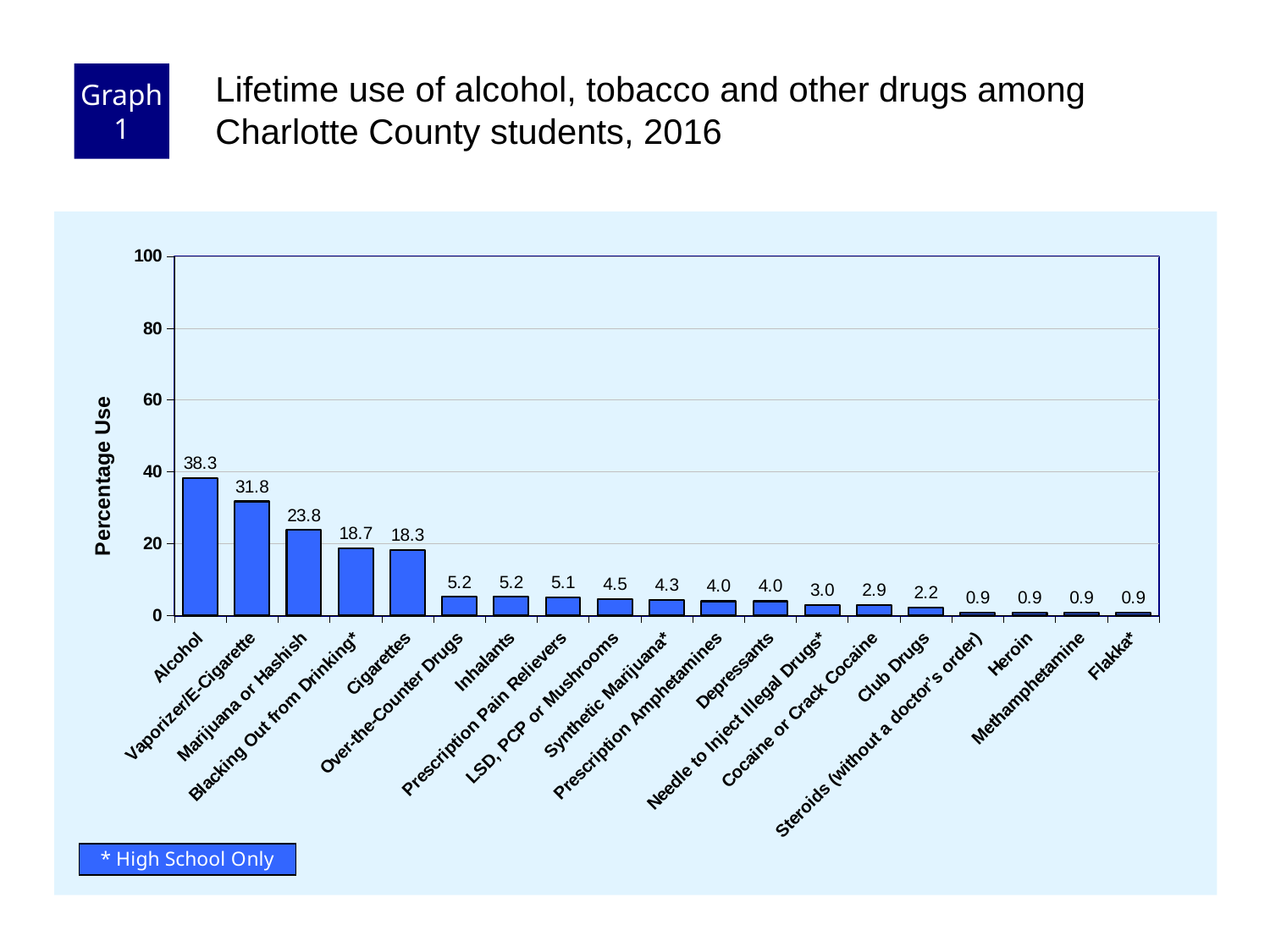
Which has a higher percentage use, Marijuana or Hashish or Cigarettes? Marijuana or Hashish How many categories are shown on the chart? 19 Which category has the highest percentage use? Alcohol What is the lowest percentage use value shown on the chart? 0.9 What is the percentage use for Cigarettes? 18.3 What is the difference in percentage use between Alcohol and Marijuana or Hashish? 14.5 What is the percentage use for Alcohol? 38.3 What is the difference in percentage use between Blacking Out from Drinking* and Cigarettes? 0.4 What type of chart is shown on the slide? Bar chart What is the percentage use for Club Drugs? 2.2 Is the value for Vaporizer/E-Cigarette greater or less than 20? greater What is the percentage use for Vaporizer/E-Cigarette? 31.8